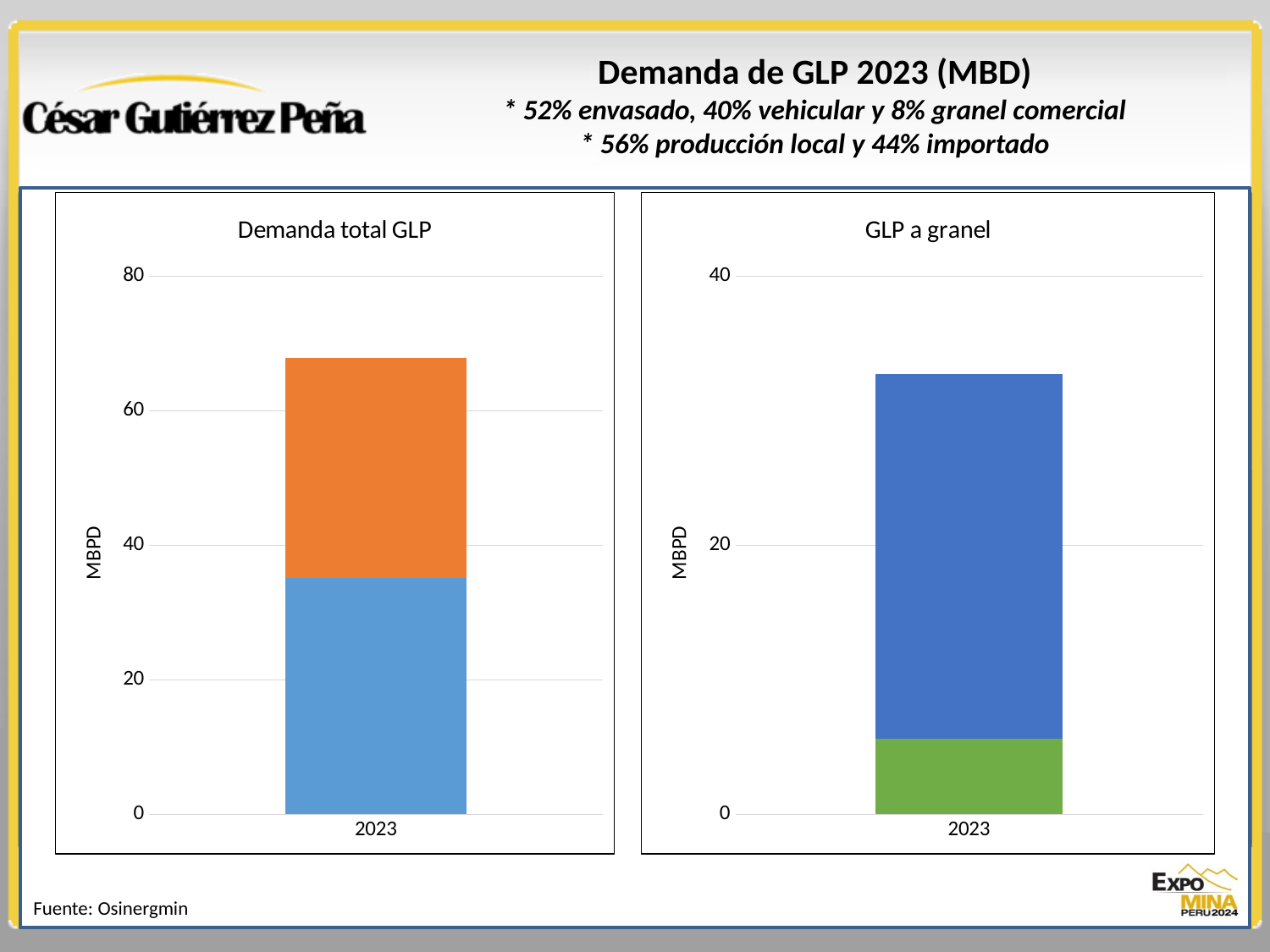
What kind of chart is the 'Demanda total GLP' chart? bar chart In the 'Demanda total GLP' chart, how many categories are shown on the x axis? 1 What is the y-axis label on the 'Demanda total GLP' chart? MBPD In the 'GLP a granel' chart, is the total height of the stacked bar for 2023 greater or less than 40? less In the 'GLP a granel' chart, is the total height of the stacked bar for 2023 greater or less than 20? greater In the 'GLP a granel' chart, is the green (bottom) segment of the 2023 bar greater or less than 10? less In the 'GLP a granel' chart, which segment of the 2023 bar is larger, the blue one or the green one? the blue one What kind of chart is the 'GLP a granel' chart? bar chart In the 'GLP a granel' chart, how many categories are shown on the x axis? 1